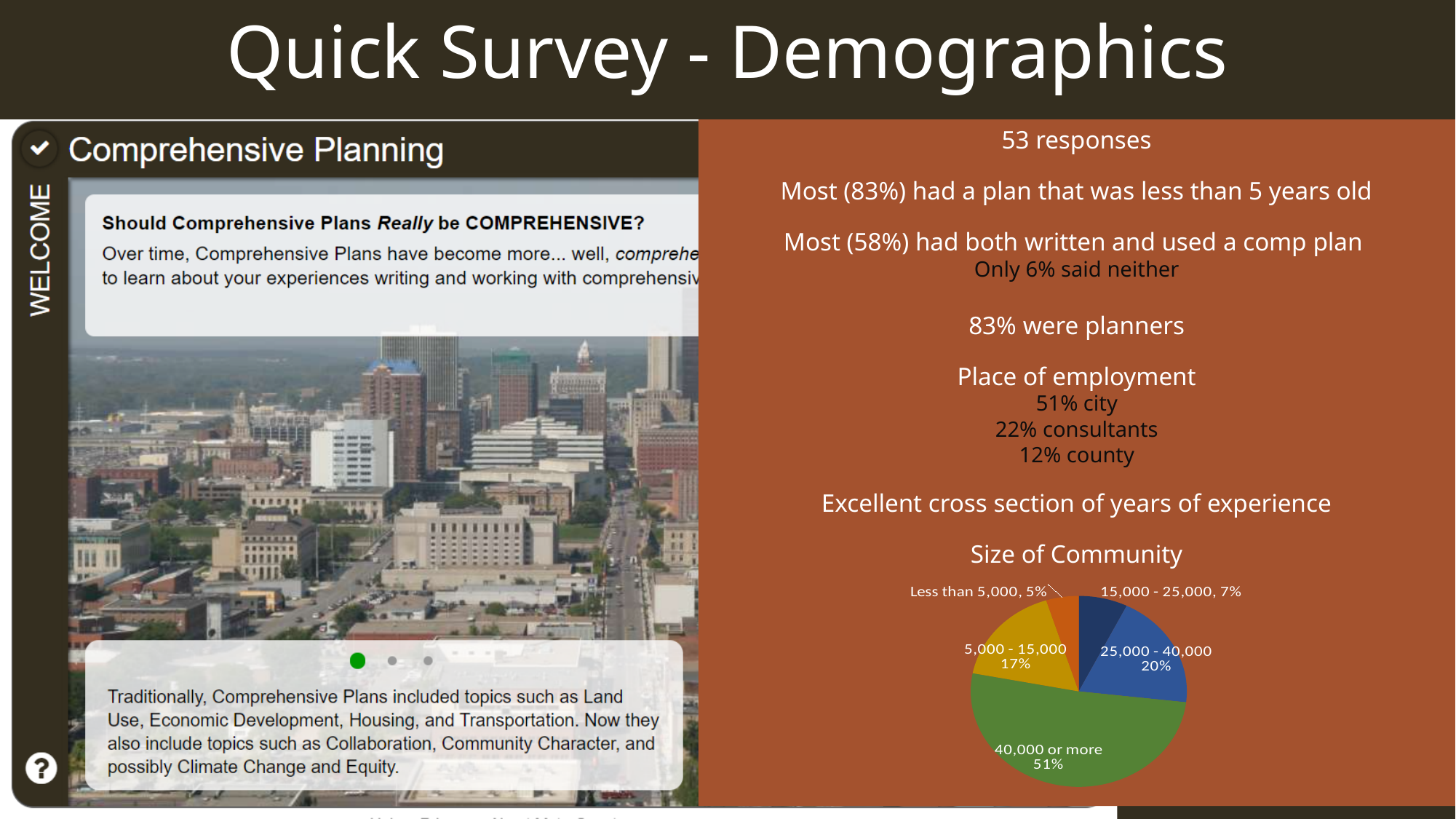
How many slices does the Size of Community pie chart have? 5 In the Size of Community pie chart, what share is shown for 15,000 - 25,000? 7% What kind of chart is the Size of Community chart? pie chart In the Size of Community pie chart, what share is shown for 40,000 or more? 51% In the Size of Community pie chart, what is the difference between the shares for 40,000 or more and 25,000 - 40,000? 31 percentage points In the Size of Community pie chart, what share is shown for 5,000 - 15,000? 17% In the Size of Community pie chart, what share is shown for 25,000 - 40,000? 20% In the Size of Community pie chart, what share is shown for Less than 5,000? 5% Which community size category has the largest slice in the Size of Community pie chart? 40,000 or more In the Size of Community pie chart, which is larger: the share for 5,000 - 15,000 or the share for 15,000 - 25,000? 5,000 - 15,000 What is the title of the pie chart on the slide? Size of Community Which community size category has the smallest slice in the Size of Community pie chart? Less than 5,000